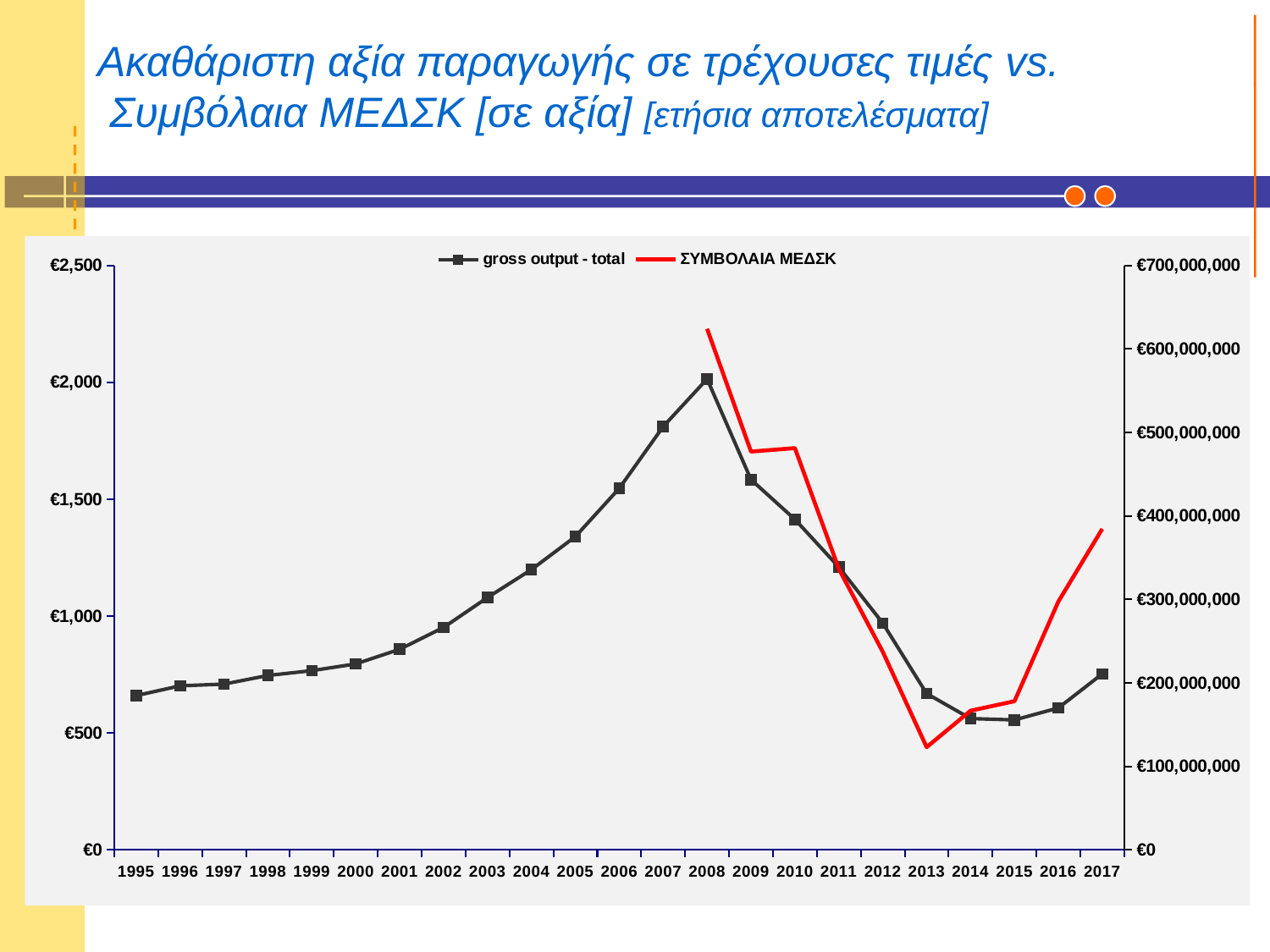
Is the 'gross output - total' value for 2008 greater or less than €1,500? greater How many series does the legend list? 2 Does the 'gross output - total' series rise or fall from 1995 to 2008? rise In which year does the 'gross output - total' series reach its highest value? 2008 Which series is drawn as a red line? ΣΥΜΒΟΛΑΙΑ ΜΕΔΣΚ Which year has the higher 'gross output - total' value, 2007 or 2009? 2007 What kind of chart is shown on the slide? line chart In which year does the 'ΣΥΜΒΟΛΑΙΑ ΜΕΔΣΚ' series reach its lowest value? 2013 Is the 'ΣΥΜΒΟΛΑΙΑ ΜΕΔΣΚ' value for 2013 greater or less than €200,000,000? less Is the 'gross output - total' value for 1995 greater or less than €1,000? less How many years are plotted along the x axis? 23